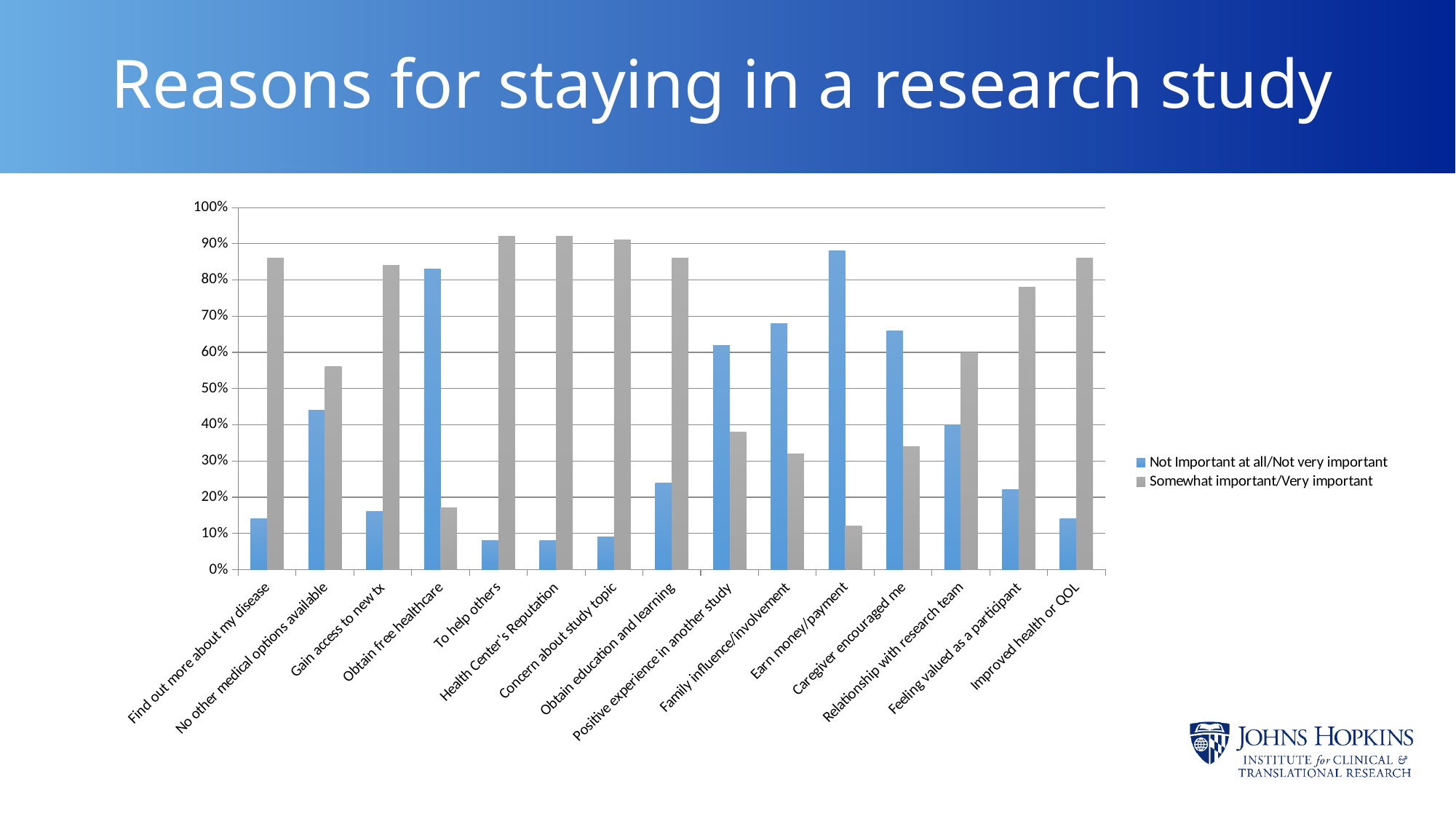
Is the 'Somewhat important/Very important' value for 'Feeling valued as a participant' greater or less than 70%? greater How many reasons (categories) are shown along the x axis? 15 Which reason has the highest 'Not Important at all/Not very important' value? Earn money/payment What colour are the bars for the 'Somewhat important/Very important' series? gray What kind of chart is shown on the slide? bar chart Is the 'Somewhat important/Very important' value for 'Find out more about my disease' greater or less than 80%? greater For 'Improved health or QOL', which series has the larger value: 'Not Important at all/Not very important' or 'Somewhat important/Very important'? Somewhat important/Very important Is the 'Not Important at all/Not very important' value for 'To help others' greater or less than 10%? less How many series does the legend list? 2 Which reason has the lowest 'Somewhat important/Very important' value? Earn money/payment For 'Caregiver encouraged me', which series has the larger value: 'Not Important at all/Not very important' or 'Somewhat important/Very important'? Not Important at all/Not very important